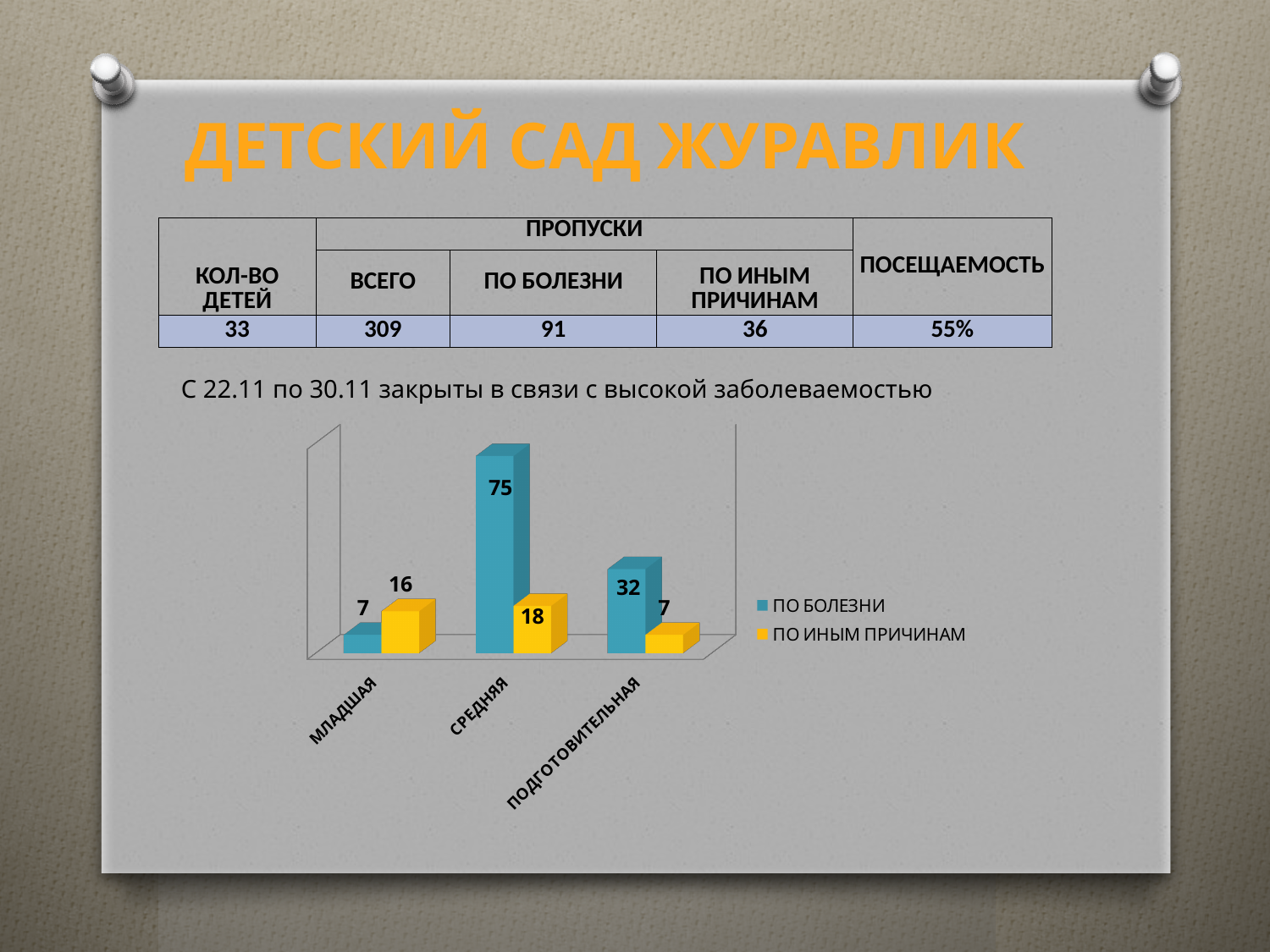
What is the value for ПО БОЛЕЗНИ in the СРЕДНЯЯ group? 75 How many series does the chart legend list? 2 What kind of chart is shown on the slide? bar chart What is the value for ПО БОЛЕЗНИ in the ПОДГОТОВИТЕЛЬНАЯ group? 32 What is the value for ПО ИНЫМ ПРИЧИНАМ in the МЛАДШАЯ group? 16 Which group has the lowest value for ПО БОЛЕЗНИ? МЛАДШАЯ Which group has the highest value for ПО БОЛЕЗНИ? СРЕДНЯЯ Which colour represents the ПО ИНЫМ ПРИЧИНАМ series in the chart? yellow What is the value for ПО ИНЫМ ПРИЧИНАМ in the ПОДГОТОВИТЕЛЬНАЯ group? 7 How many groups are shown on the x axis of the chart? 3 What is the difference between ПО БОЛЕЗНИ and ПО ИНЫМ ПРИЧИНАМ in the СРЕДНЯЯ group? 57 In the МЛАДШАЯ group, which is larger: ПО БОЛЕЗНИ or ПО ИНЫМ ПРИЧИНАМ? ПО ИНЫМ ПРИЧИНАМ